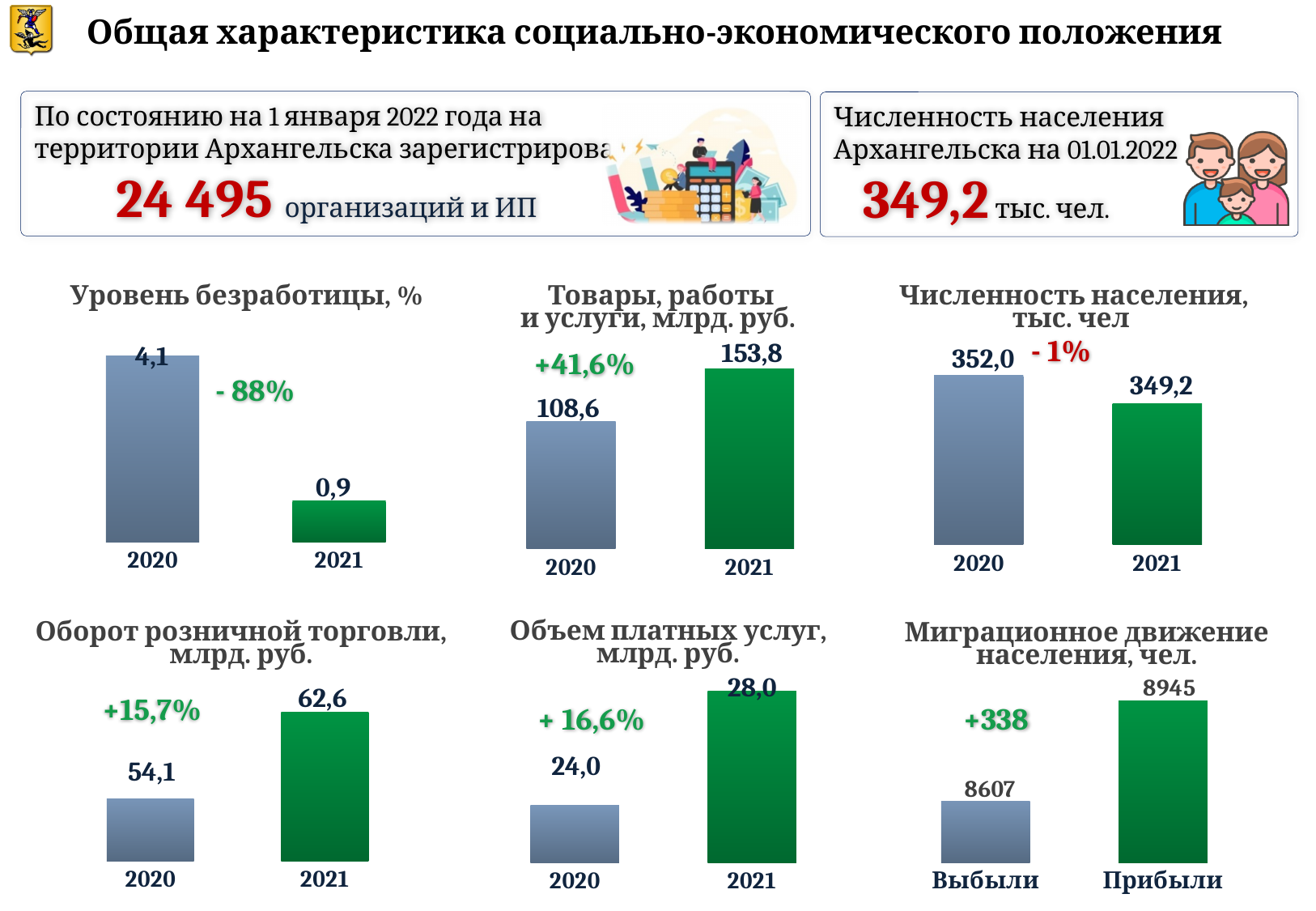
In the 'Объем платных услуг, млрд. руб.' chart, which year has the higher value? 2021 In the 'Численность населения, тыс. чел' chart, which year has the lower value? 2021 In the 'Объем платных услуг, млрд. руб.' chart, what is the value for 2020? 24,0 In the 'Миграционное движение населения, чел.' chart, what is the value for 'Прибыли'? 8945 What type of chart is the 'Оборот розничной торговли, млрд. руб.' chart? Bar chart In the 'Уровень безработицы, %' chart, what is the value for 2020? 4,1 In the 'Миграционное движение населения, чел.' chart, how many categories are shown? 2 In the 'Уровень безработицы, %' chart, what is the value for 2021? 0,9 In the 'Товары, работы и услуги, млрд. руб.' chart, what is the difference between the 2021 and 2020 values? 45,2 In the 'Оборот розничной торговли, млрд. руб.' chart, what is the difference between the 2021 and 2020 values? 8,5 In the 'Товары, работы и услуги, млрд. руб.' chart, what is the value for 2021? 153,8 In the 'Численность населения, тыс. чел' chart, what is the value for 2020? 352,0